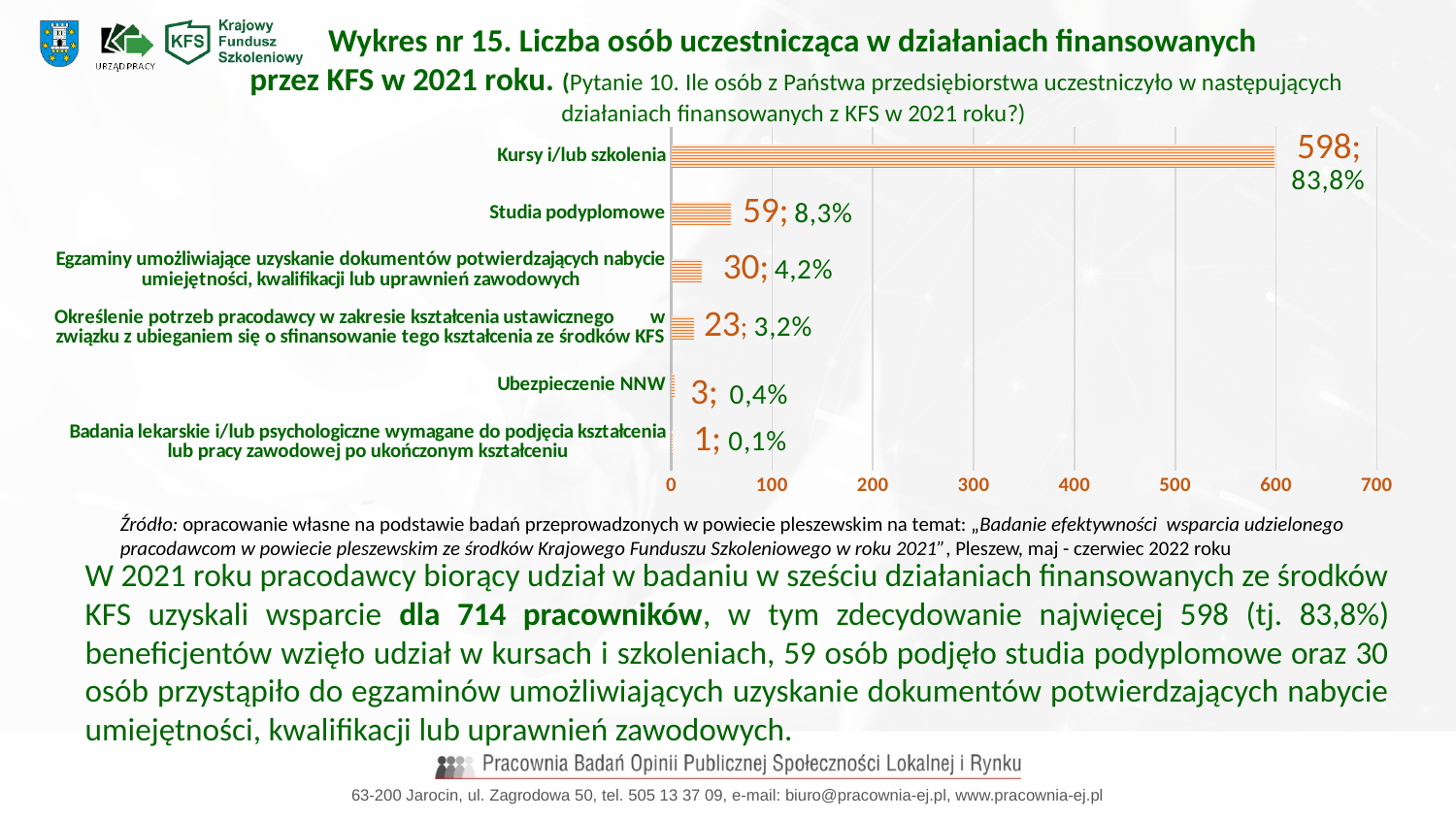
What is the number of people for "Kursy i/lub szkolenia"? 598 What is the value for "Ubezpieczenie NNW"? 3 How many categories are plotted in the chart? 6 What is the difference between the values for "Studia podyplomowe" and "Egzaminy umożliwiające uzyskanie dokumentów potwierdzających nabycie umiejętności, kwalifikacji lub uprawnień zawodowych"? 29 What percentage is shown for "Określenie potrzeb pracodawcy w zakresie kształcenia ustawicznego w związku z ubieganiem się o sfinansowanie tego kształcenia ze środków KFS"? 3,2% What is the maximum value shown on the horizontal axis? 700 What percentage is shown for "Studia podyplomowe"? 8,3% What type of chart is shown on the slide? bar chart Which category has the lowest value? Badania lekarskie i/lub psychologiczne wymagane do podjęcia kształcenia lub pracy zawodowej po ukończonym kształceniu Which category has the highest value? Kursy i/lub szkolenia Is the value for "Kursy i/lub szkolenia" greater or less than 500? greater Which is larger: the value for "Ubezpieczenie NNW" or the value for "Określenie potrzeb pracodawcy w zakresie kształcenia ustawicznego w związku z ubieganiem się o sfinansowanie tego kształcenia ze środków KFS"? Określenie potrzeb pracodawcy w zakresie kształcenia ustawicznego w związku z ubieganiem się o sfinansowanie tego kształcenia ze środków KFS